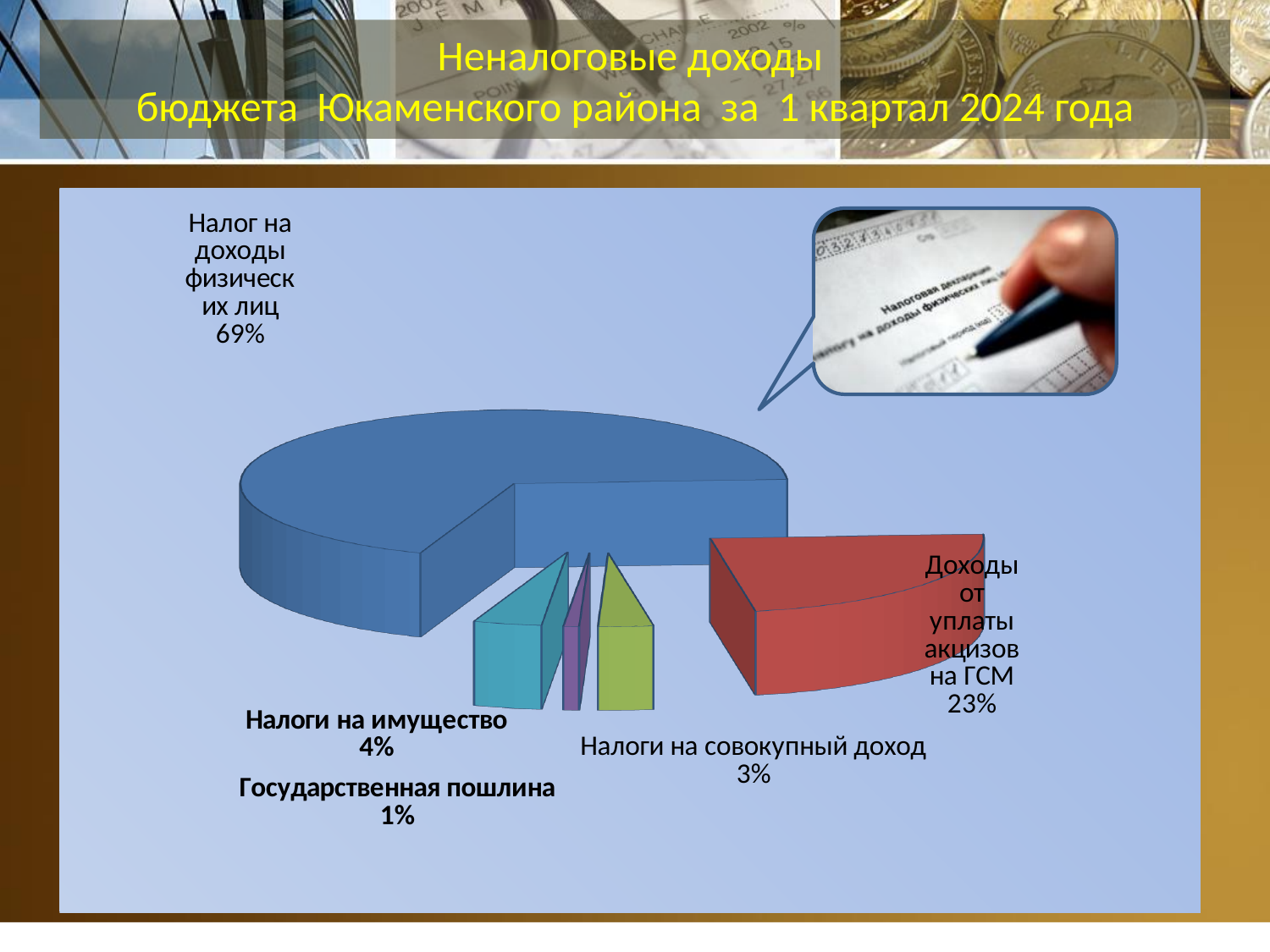
What share of the pie is labelled for Налоги на имущество? 4% Which category has the largest slice of the pie? Налог на доходы физических лиц What share of the pie is labelled for Доходы от уплаты акцизов на ГСМ? 23% What is the difference in percentage points between Налог на доходы физических лиц and Доходы от уплаты акцизов на ГСМ? 46 What share of the pie is labelled for Государственная пошлина? 1% Which category has the smallest slice of the pie? Государственная пошлина What share of the pie is labelled for Налог на доходы физических лиц? 69% What share of the pie is labelled for Налоги на совокупный доход? 3% Which is larger: the share for Налоги на имущество or the share for Налоги на совокупный доход? Налоги на имущество What colour is the slice for Доходы от уплаты акцизов на ГСМ? red How many slices does the pie chart have? 5 What kind of chart is shown on the slide? pie chart